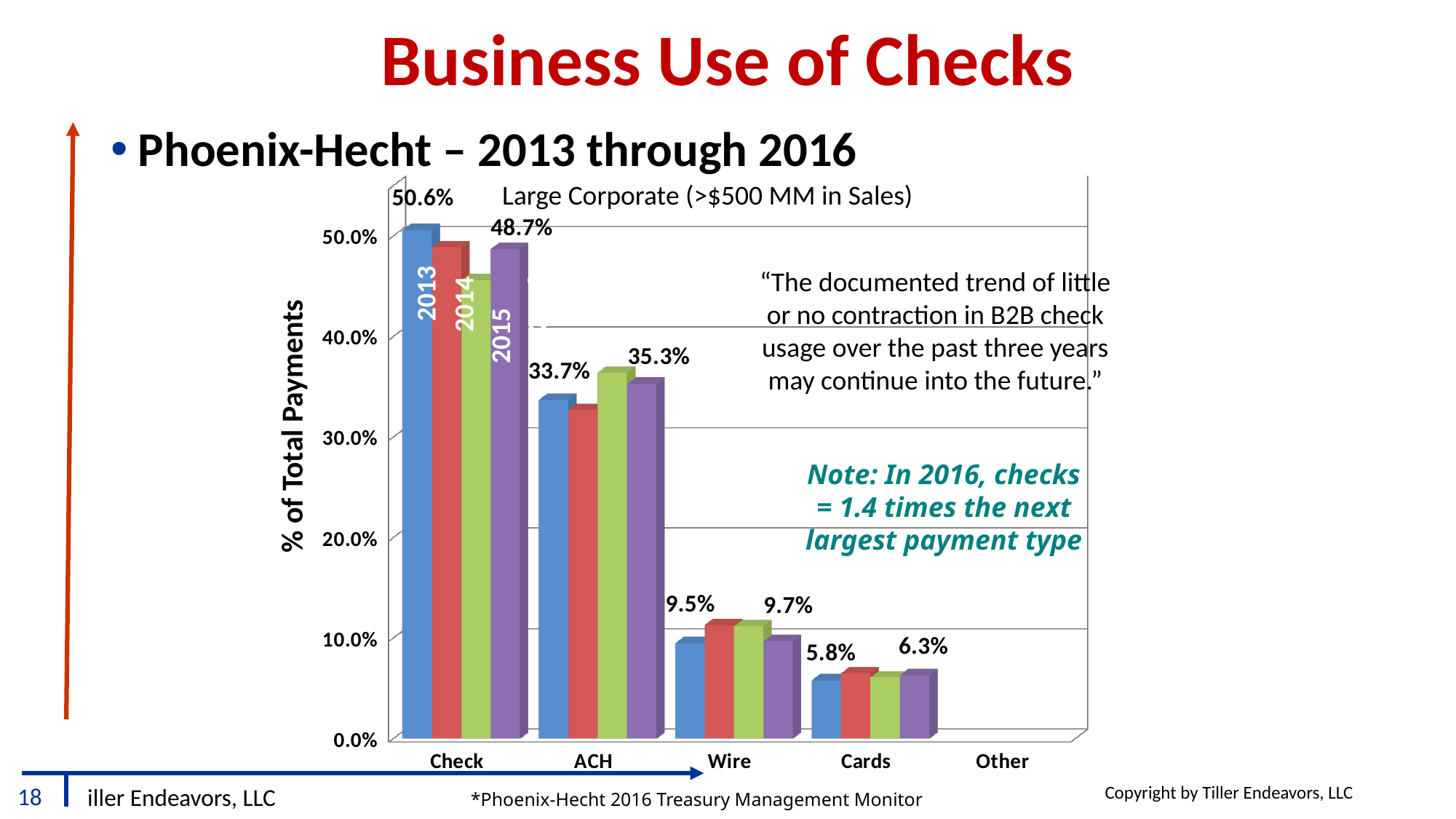
What is the 2013 value for Check in the Large Corporate chart? 50.6% What is the 2013 value for Cards? 5.8% What value is labelled on the last (purple) bar for Check? 48.7% What is the 2013 value for ACH? 33.7% What is the difference between the 2013 Check value (50.6%) and the last purple Check bar (48.7%)? 1.9 percentage points What value is labelled on the last (purple) bar for ACH? 35.3% Is the 2014 (green) bar for Check greater or less than 40.0%? greater For 2013, which is larger: Check or ACH? Check What is the 2013 value for Wire? 9.5% How many payment-type categories are shown on the x axis? 5 What is the title of the y axis? % of Total Payments Which payment type has the highest share of total payments? Check